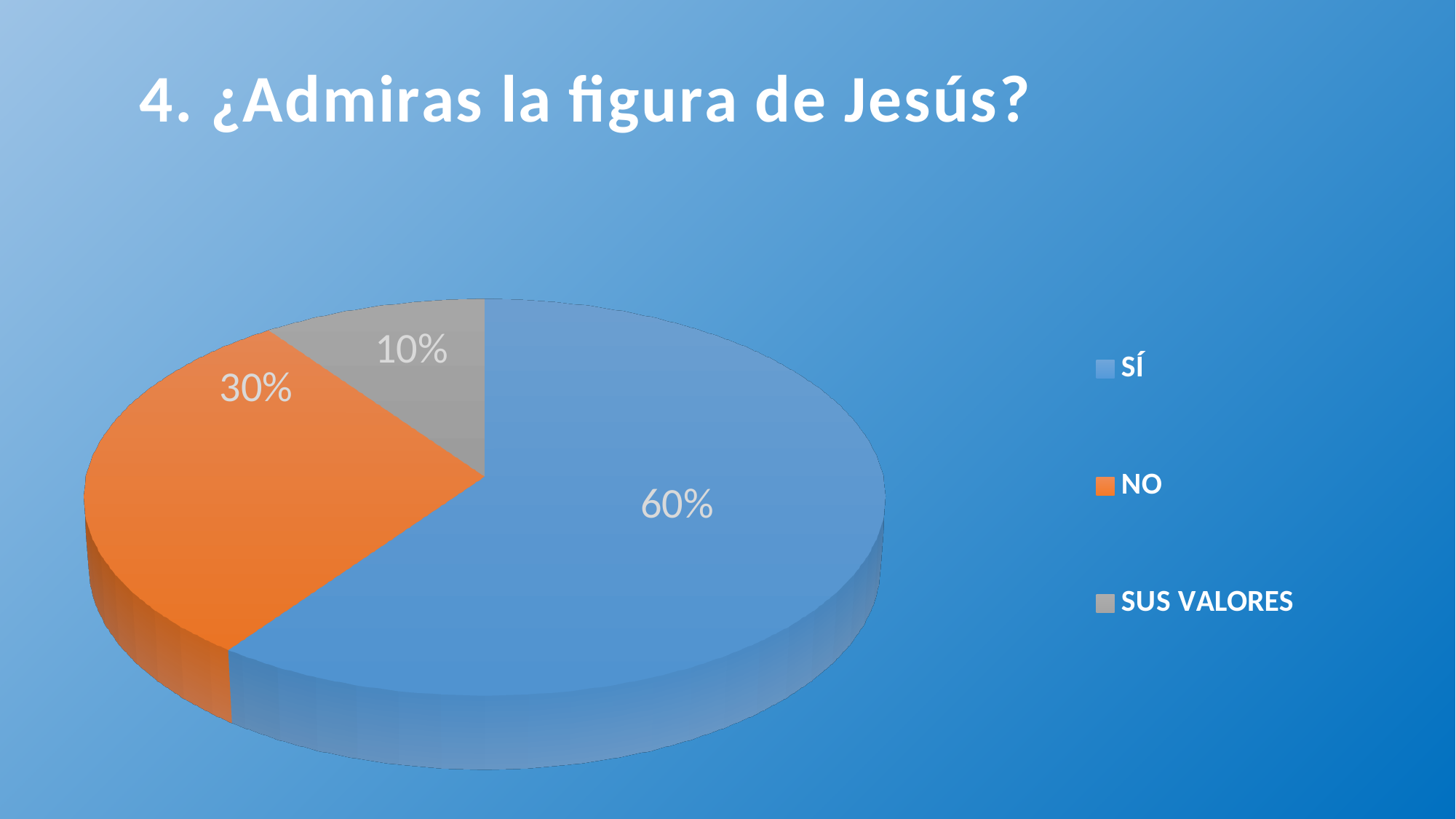
How many slices does the pie chart have? 3 Which category has the smallest share of the pie? SUS VALORES What percentage of the pie is labelled SUS VALORES? 10% What colour is the slice for NO? Orange Which slice is larger, NO or SUS VALORES? NO What is the difference in percentage points between the NO and SUS VALORES slices? 20% What is the difference in percentage points between the SÍ and NO slices? 30% What kind of chart is shown on the slide? Pie chart What is the title of the slide above the chart? 4. ¿Admiras la figura de Jesús? Which category has the largest share of the pie? SÍ What percentage of the pie is labelled SÍ? 60% What percentage of the pie is labelled NO? 30%